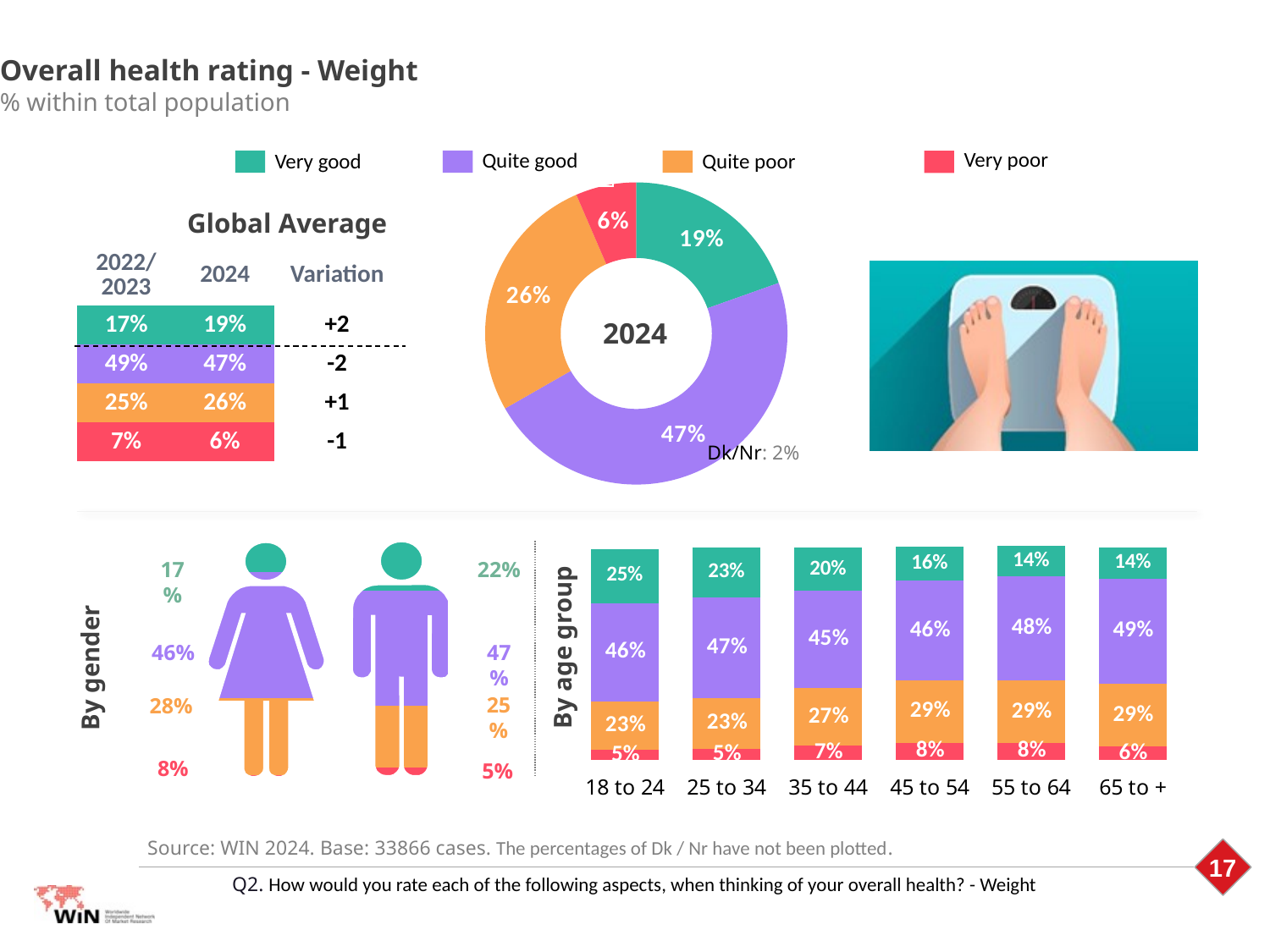
In the By age group chart, what is the Very good percentage for 18 to 24? 25% In the 2024 donut chart, which rating category has the largest share? Quite good In the By age group chart, does the Very good percentage rise or fall from the youngest to the oldest age group? Fall How many age groups are shown in the By age group chart? 6 In the 2024 donut chart, which rating category has the smallest share? Very poor In the By gender chart, what is the Very good percentage for men? 22% What kind of chart is the 2024 chart in the top centre of the slide? Donut (pie) chart In the By age group chart, what is the Quite poor percentage for 35 to 44? 27% In the By age group chart, which age group has the highest Very good percentage? 18 to 24 How many series does the legend at the top of the slide list? 4 In the By age group chart, what is the difference between the Quite good percentage for 65 to + and for 18 to 24? 3 percentage points In the 2024 donut chart, what percentage rated their weight as Quite good? 47%